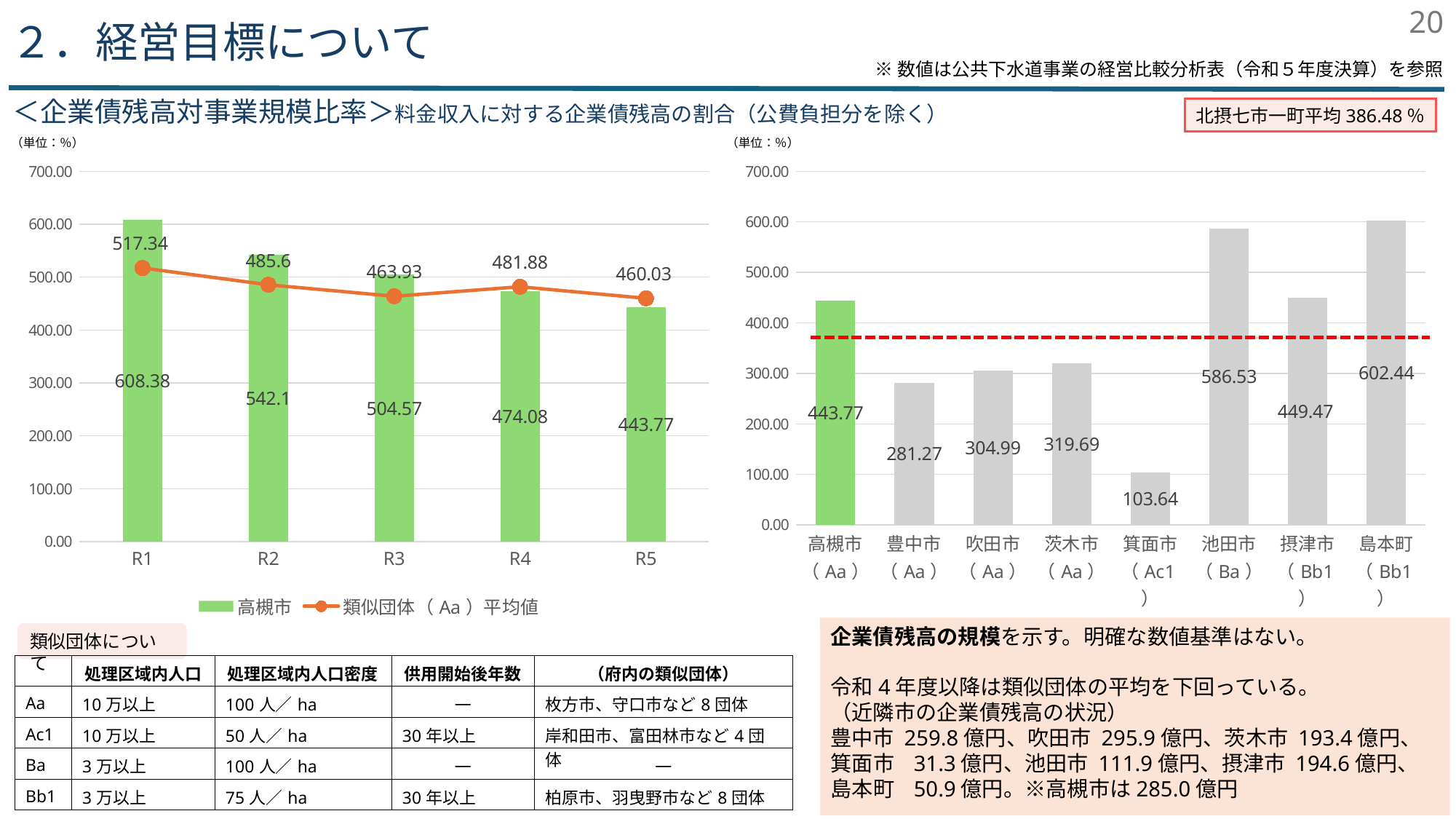
In the left chart, do the 高槻市 bars rise or fall from R1 to R5? fall What kind of chart is the right chart? bar chart In the left chart, what is the value for 高槻市 in R3? 504.57 In the left chart, which is larger in R5: the 高槻市 value or the 類似団体（Aa）平均値 value? 類似団体（Aa）平均値 In the right chart, which municipality has the highest value? 島本町 In the left chart, what is the difference between the 高槻市 value and the 類似団体（Aa）平均値 value in R1? 91.04 How many municipalities are shown in the right chart? 8 In the right chart, what is the value for 茨木市? 319.69 In the left chart, what is the 類似団体（Aa）平均値 value in R4? 481.88 In the right chart, what is the difference between the values for 池田市 and 摂津市? 137.06 How many series does the legend of the left chart list? 2 In the right chart, which municipality has the lowest value? 箕面市